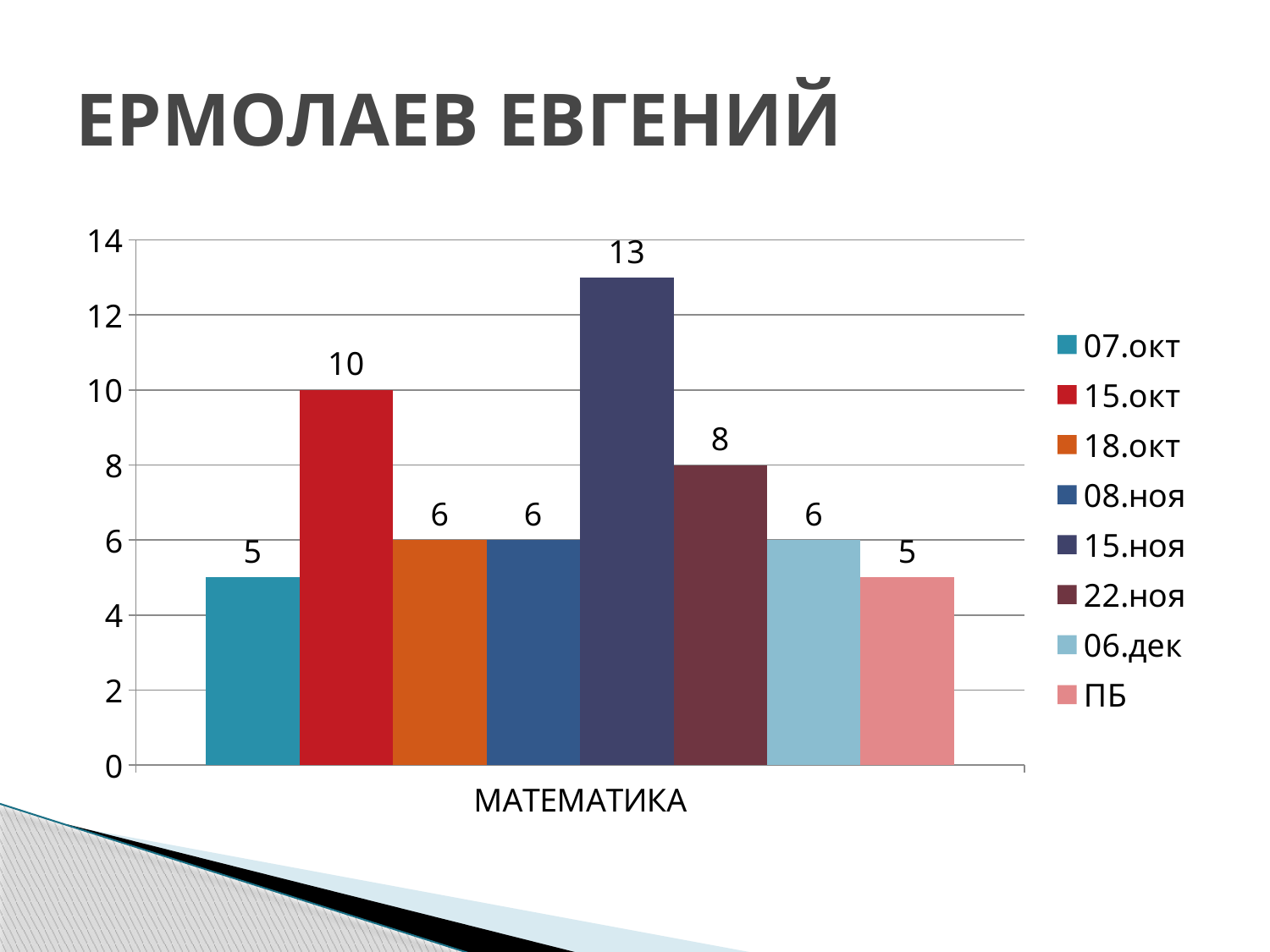
What is the difference between the 15.ноя value and the 15.окт value? 3 What kind of chart is shown on the slide? bar chart What is the value for the ПБ series? 5 What is the value for the 15.окт series? 10 How many series does the legend list? 8 Which is larger, the value for 22.ноя or the value for 06.дек? 22.ноя What is the title of the slide? ЕРМОЛАЕВ ЕВГЕНИЙ What is the value for the 15.ноя series in the МАТЕМАТИКА category? 13 Which series has the highest value? 15.ноя What is the value for the 22.ноя series? 8 What is the category label on the x axis? МАТЕМАТИКА Is the value for 15.ноя greater or less than 12? greater